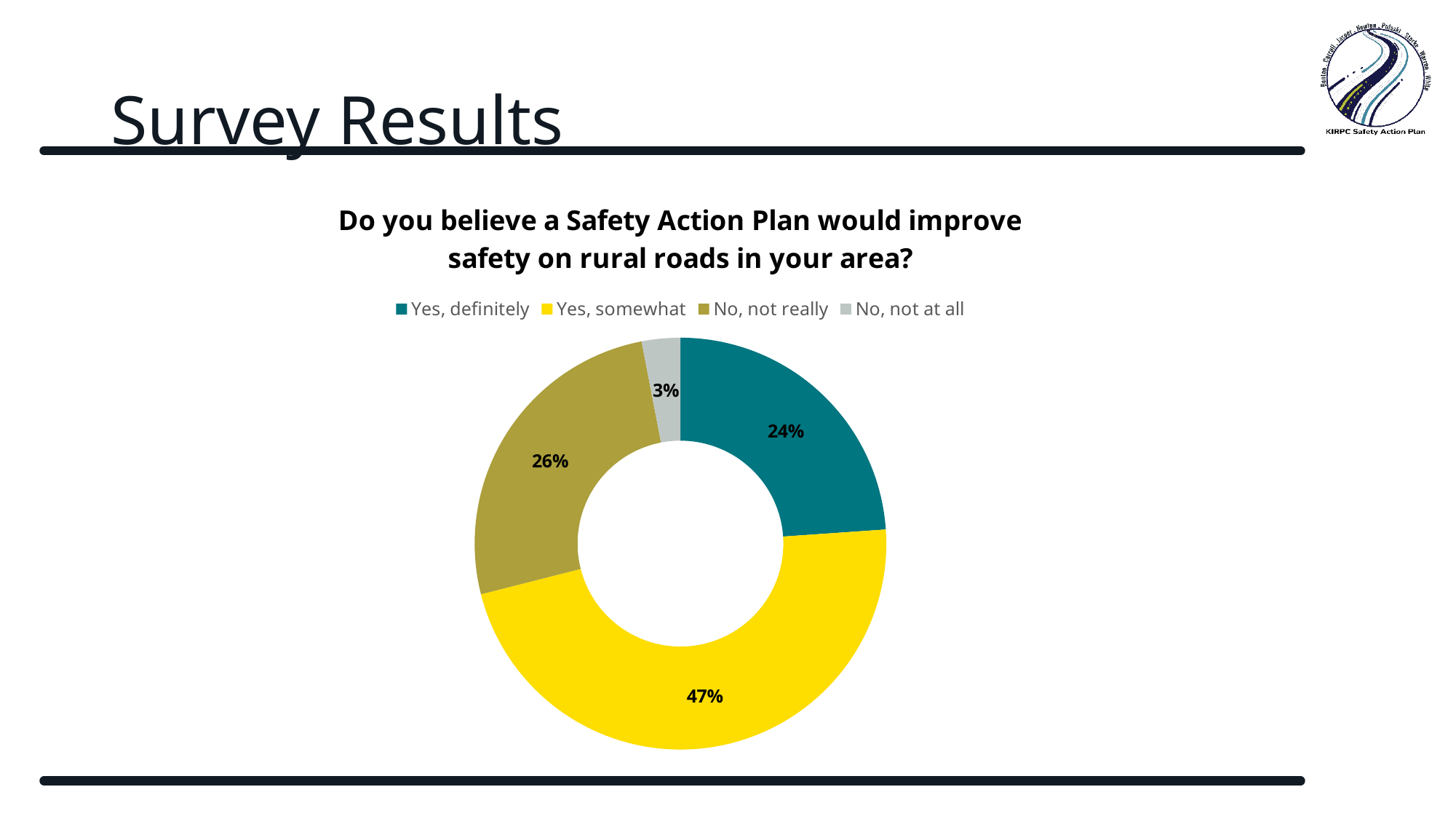
What is the difference in percentage points between "Yes, somewhat" and "Yes, definitely"? 23 Which response has the smallest share of the chart? No, not at all What percentage of respondents answered "Yes, somewhat"? 47% Which is larger: the share for "No, not really" or the share for "Yes, definitely"? No, not really What percentage of respondents answered "Yes, definitely"? 24% What percentage of respondents answered "No, not really"? 26% What kind of chart is shown on the slide? Doughnut (pie) chart What is the title of the chart? Do you believe a Safety Action Plan would improve safety on rural roads in your area? What is the combined percentage of the two "Yes" responses? 71% What percentage of respondents answered "No, not at all"? 3% How many response categories are shown in the chart? 4 Which response has the largest share of the chart? Yes, somewhat